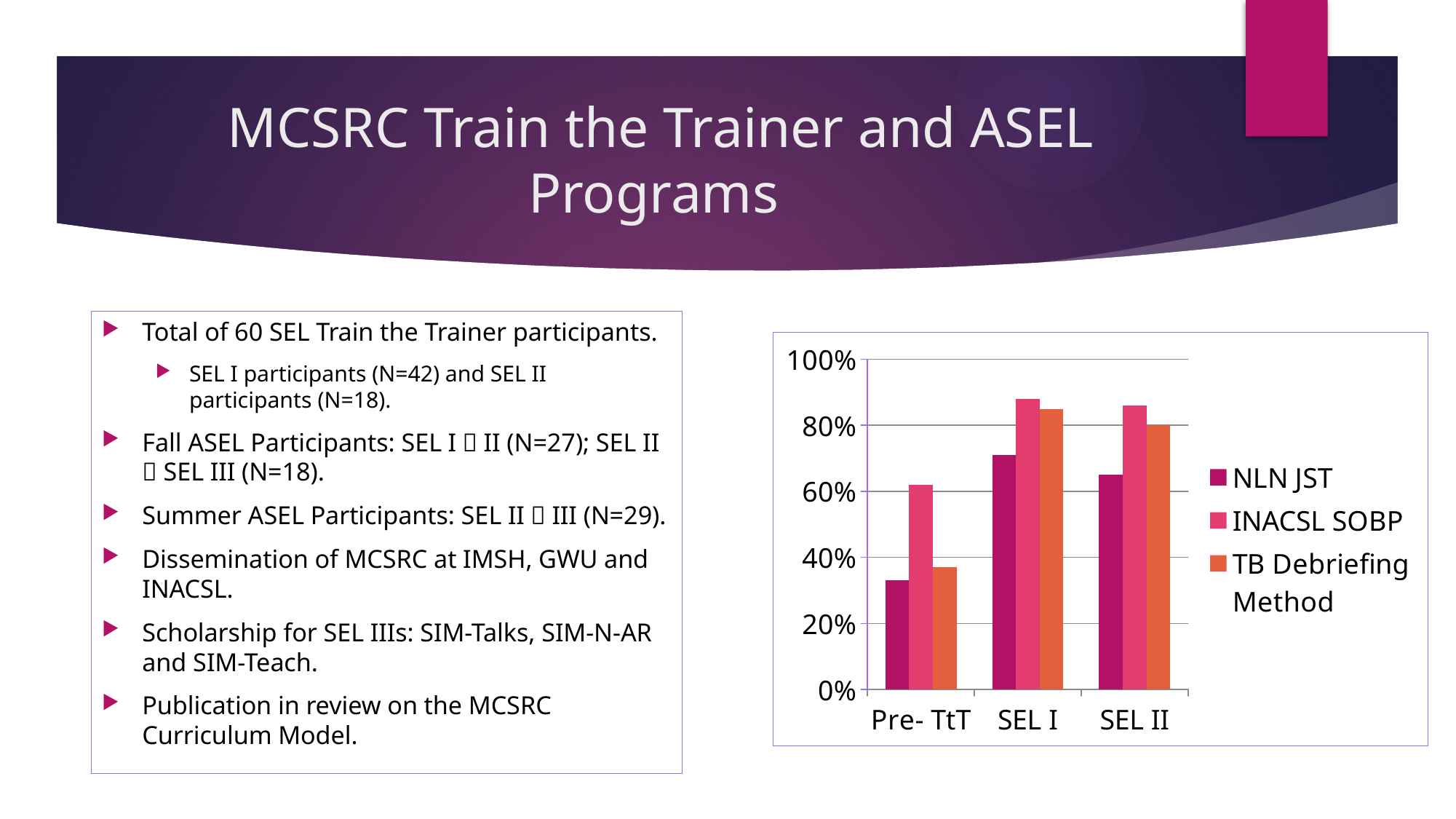
Is the value for NLN JST at SEL II greater or less than 80%? less Is the value for NLN JST at Pre- TtT greater or less than 40%? less Which series is shown in orange in the chart legend? TB Debriefing Method In which category is the NLN JST value highest? SEL I In which category is the INACSL SOBP value lowest? Pre- TtT Is the value for INACSL SOBP at Pre- TtT greater or less than 40%? greater How many categories are shown on the x axis of the chart? 3 What kind of chart is shown on the slide? bar chart How many series does the chart legend list? 3 At SEL II, which is larger: NLN JST or INACSL SOBP? INACSL SOBP